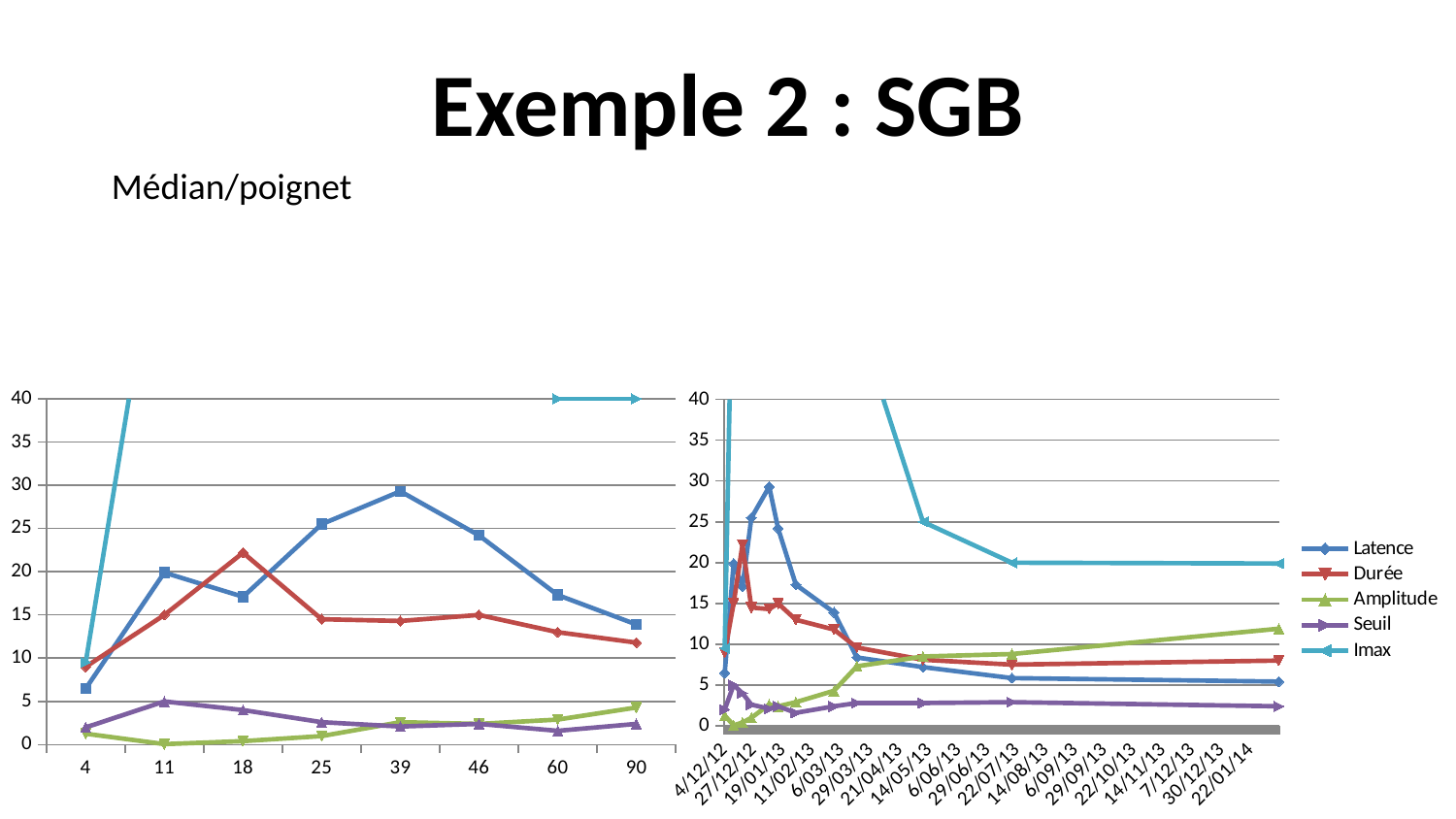
How many series does the legend of the right chart list? 5 In the left chart, is the value of the red series at 18 greater or less than 20? greater In the right chart, at 22/01/14, which series has the larger value, Amplitude or Durée? Amplitude What type of chart is the left chart on the slide? line chart In the left chart, at which x-axis category does the red series reach its highest value? 18 In the left chart, at x = 25, which series has the larger value, the blue series or the red series? the blue series In the left chart, at which x-axis category does the blue series reach its highest value? 39 In the right chart, is the value of Amplitude at 22/01/14 greater or less than 10? greater In the left chart, does the blue series rise or fall between 39 and 90? fall How many categories are shown on the x axis of the left chart? 8 Which series in the right chart is drawn in light blue (cyan)? Imax In the left chart, is the value of the blue series at 4 greater or less than 10? less